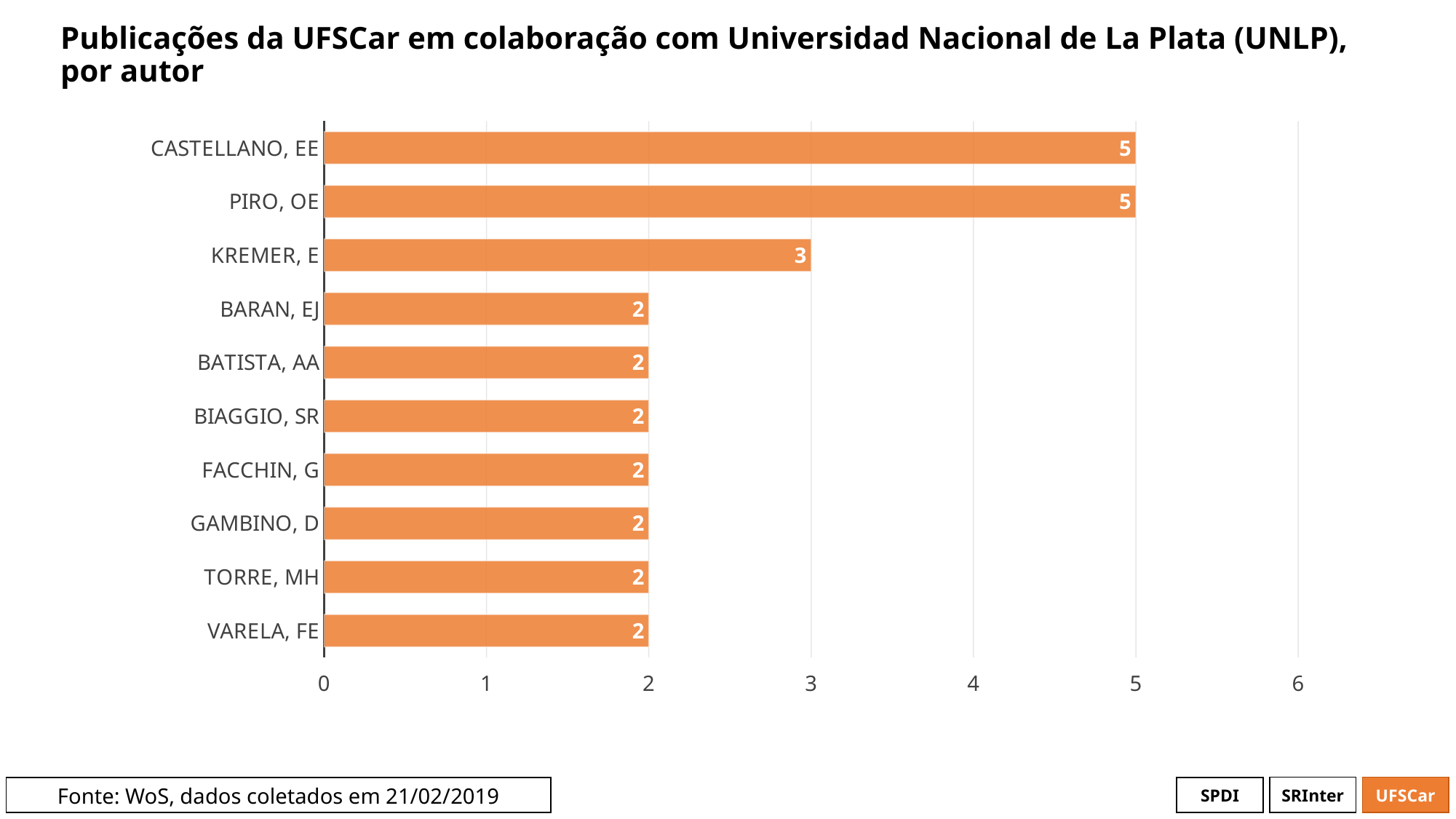
What is the difference between the values for KREMER, E and BARAN, EJ? 1 Is the value for KREMER, E greater or less than 4? less What is the difference between the values for CASTELLANO, EE and KREMER, E? 2 How many authors are shown in the chart? 10 What kind of chart is shown on the slide? bar chart What is the value for PIRO, OE? 5 What is the value for KREMER, E? 3 What is the value for VARELA, FE? 2 Which is larger, the value for TORRE, MH or the value for KREMER, E? KREMER, E Which is larger, the value for PIRO, OE or the value for GAMBINO, D? PIRO, OE What is the value for CASTELLANO, EE? 5 What is the title of the chart? Publicações da UFSCar em colaboração com Universidad Nacional de La Plata (UNLP), por autor